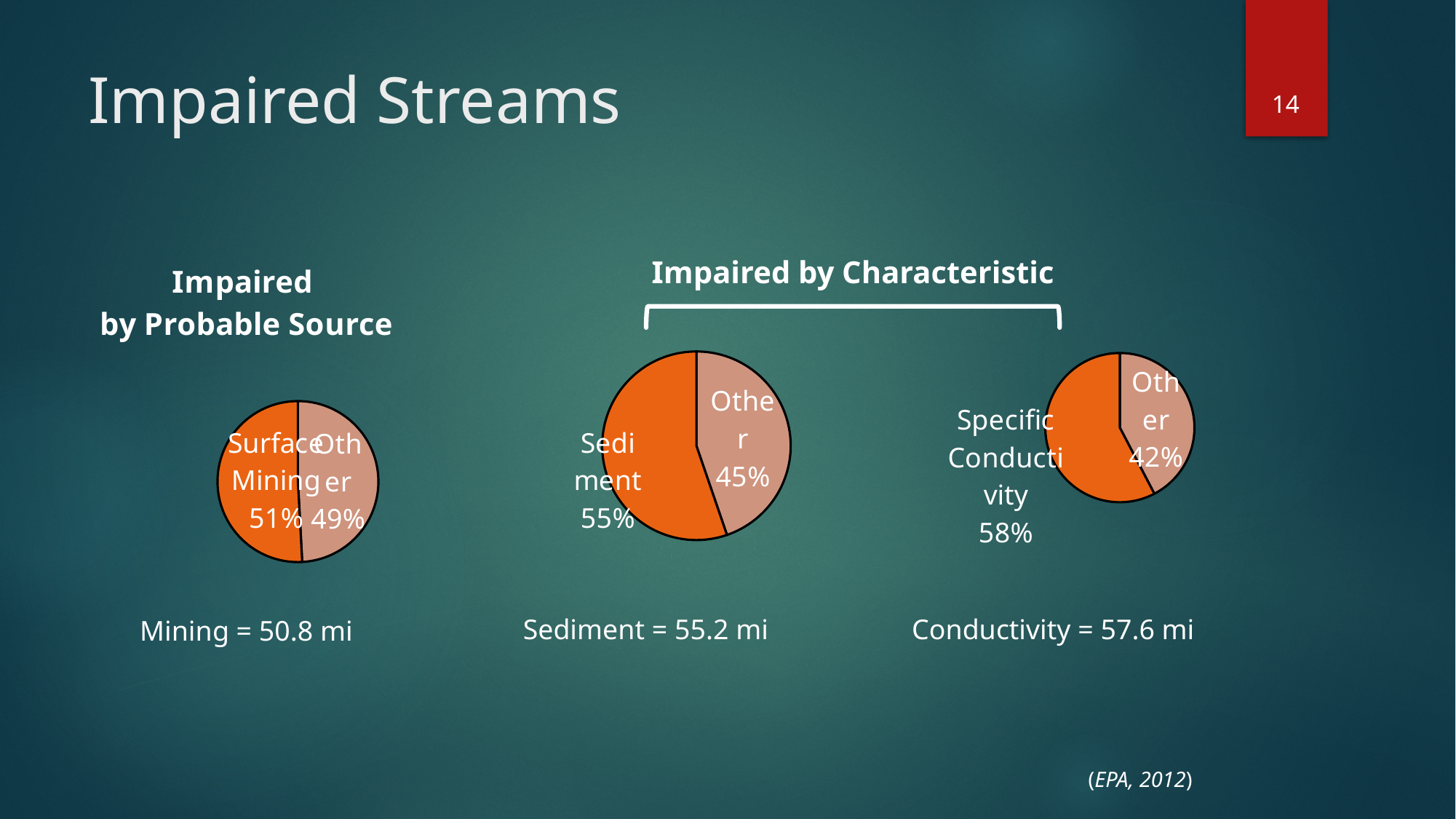
In the middle pie chart under 'Impaired by Characteristic', what share is labelled for Sediment? 55% In the middle pie chart, what is the difference in percentage points between the Sediment slice and the Other slice? 10 What type of chart is used for 'Impaired by Probable Source' on the left of the slide? Pie chart How many slices does the 'Impaired by Probable Source' pie chart on the left have? 2 In the 'Impaired by Probable Source' pie chart on the left, what share is labelled for Surface Mining? 51% In the rightmost pie chart under 'Impaired by Characteristic', what share is labelled for Specific Conductivity? 58% In the rightmost pie chart, which slice is the largest? Specific Conductivity In the middle pie chart, which slice is larger, Sediment or Other? Sediment In the rightmost pie chart, what is the difference in percentage points between the Specific Conductivity slice and the Other slice? 16 In the middle pie chart under 'Impaired by Characteristic', what share is labelled for Other? 45% In the rightmost pie chart under 'Impaired by Characteristic', what share is labelled for Other? 42% In the 'Impaired by Probable Source' pie chart on the left, what share is labelled for Other? 49%